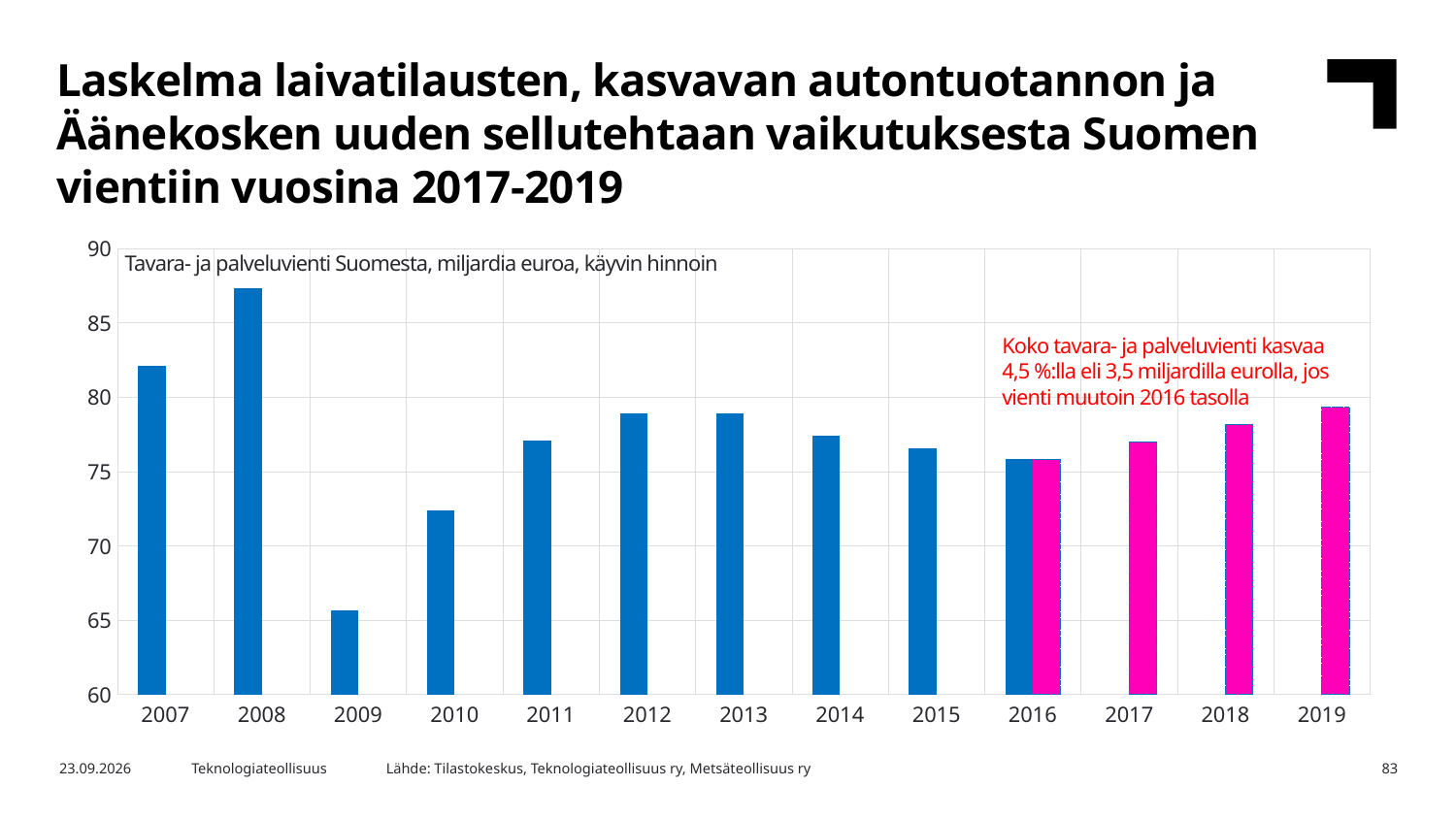
Do the values rise or fall from 2016 to 2019? Rise Which year has the lowest bar in the chart? 2009 Is the value for 2008 greater or less than 85? greater Is the value for 2019 greater or less than 80? less How many years are shown on the x axis of the chart? 13 Which is larger, the value for 2007 or the value for 2015? 2007 Which is larger, the value for 2016 or the value for 2019? 2019 Which year has the highest bar in the chart? 2008 Is the value for 2010 greater or less than 75? less What kind of chart is shown on the slide? Bar chart What is the text shown at the top of the chart area describing the data? Tavara- ja palveluvienti Suomesta, miljardia euroa, käyvin hinnoin